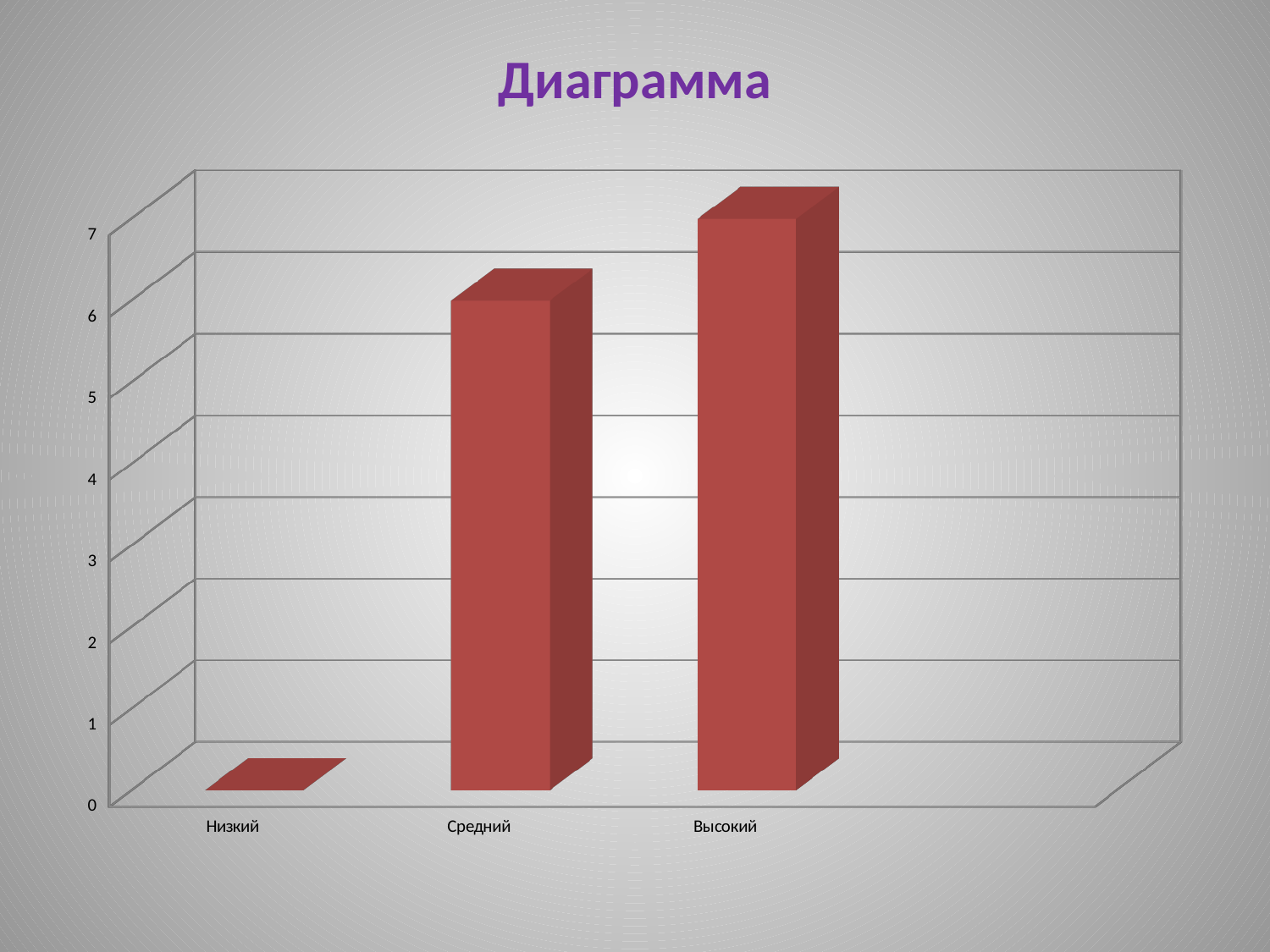
Do the values rise or fall moving from Низкий to Высокий along the x axis? rise Is the value for Высокий greater or less than 6? greater Which is larger, the value for Низкий or the value for Средний? Средний Is the value for Средний greater or less than 5? greater Which category has the highest bar? Высокий Which is larger, the value for Средний or the value for Высокий? Высокий What kind of chart is shown on the slide? bar chart How many categories are shown on the x axis of the chart? 3 What is the title of the slide above the chart? Диаграмма What colour are the bars in the chart? red Is the value for Низкий greater or less than 1? less Which category has the lowest bar? Низкий